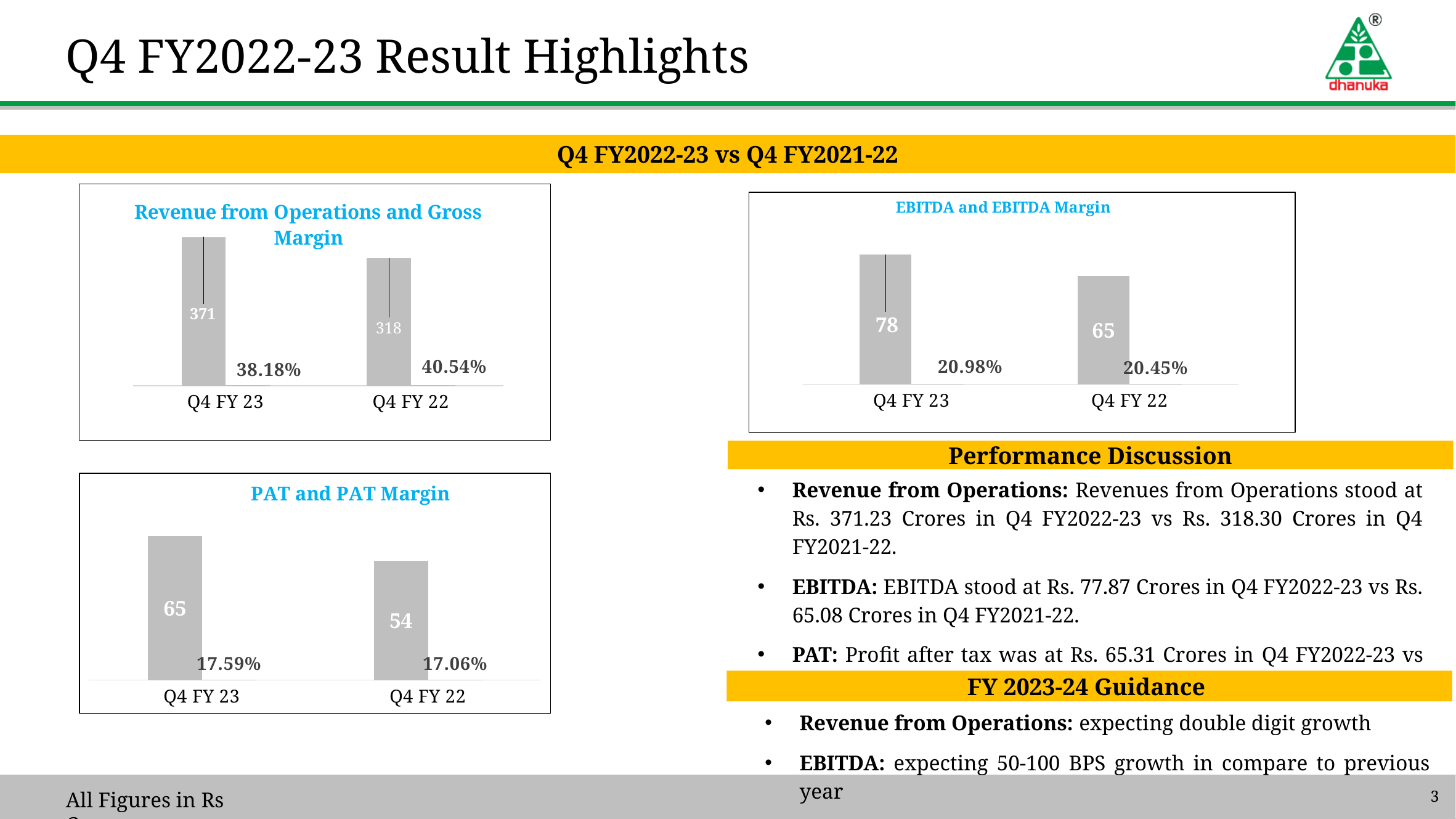
What type of chart is the 'EBITDA and EBITDA Margin' chart? Bar chart In the 'EBITDA and EBITDA Margin' chart, which period has the higher EBITDA, Q4 FY 23 or Q4 FY 22? Q4 FY 23 In the 'EBITDA and EBITDA Margin' chart, what is the EBITDA margin for Q4 FY 23? 20.98% In the 'EBITDA and EBITDA Margin' chart, what is the EBITDA value for Q4 FY 22? 65 How many periods are shown on the x axis of the 'Revenue from Operations and Gross Margin' chart? 2 In the 'PAT and PAT Margin' chart, what is the difference between the PAT for Q4 FY 23 and Q4 FY 22? 11 In the 'Revenue from Operations and Gross Margin' chart, what is the gross margin shown for Q4 FY 22? 40.54% In the 'PAT and PAT Margin' chart, what is the PAT value for Q4 FY 22? 54 In the 'Revenue from Operations and Gross Margin' chart, what is the revenue value for Q4 FY 23? 371 In the 'Revenue from Operations and Gross Margin' chart, what is the difference between the revenue for Q4 FY 23 and Q4 FY 22? 53 In the 'PAT and PAT Margin' chart, which period has the lowest PAT? Q4 FY 22 In the 'PAT and PAT Margin' chart, what is the PAT margin for Q4 FY 23? 17.59%